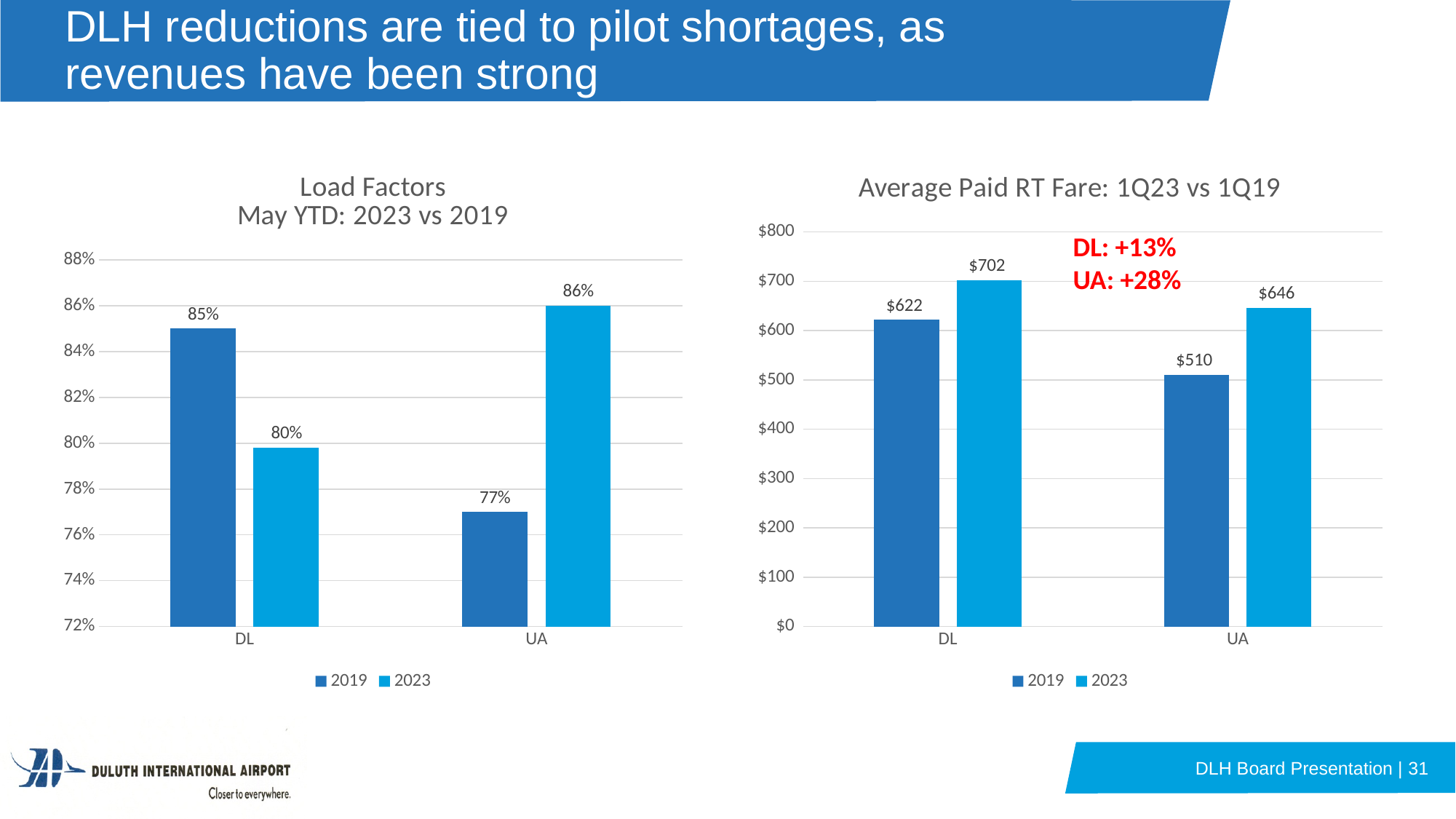
What type of chart is the Average Paid RT Fare chart? Bar chart In the Load Factors chart, what is the 2023 load factor for UA? 86% In the Average Paid RT Fare chart, which bar is the highest? DL 2023 ($702) How many series does the legend of the Load Factors chart list? 2 In the Average Paid RT Fare chart, what is the 2023 fare for DL? $702 In the Load Factors chart, did DL's load factor rise or fall from 2019 to 2023? fall In the Load Factors chart, which carrier has the lower 2019 load factor? UA In the Load Factors chart, what is the 2019 load factor for DL? 85% In the Average Paid RT Fare chart, which is larger: DL's 2019 fare or UA's 2023 fare? UA's 2023 fare ($646) In the Average Paid RT Fare chart, what is the 2019 fare for UA? $510 In the Average Paid RT Fare chart, what is the difference between UA's 2023 and 2019 fares? $136 In the Load Factors chart, is the 2023 load factor for DL greater or less than 82%? less